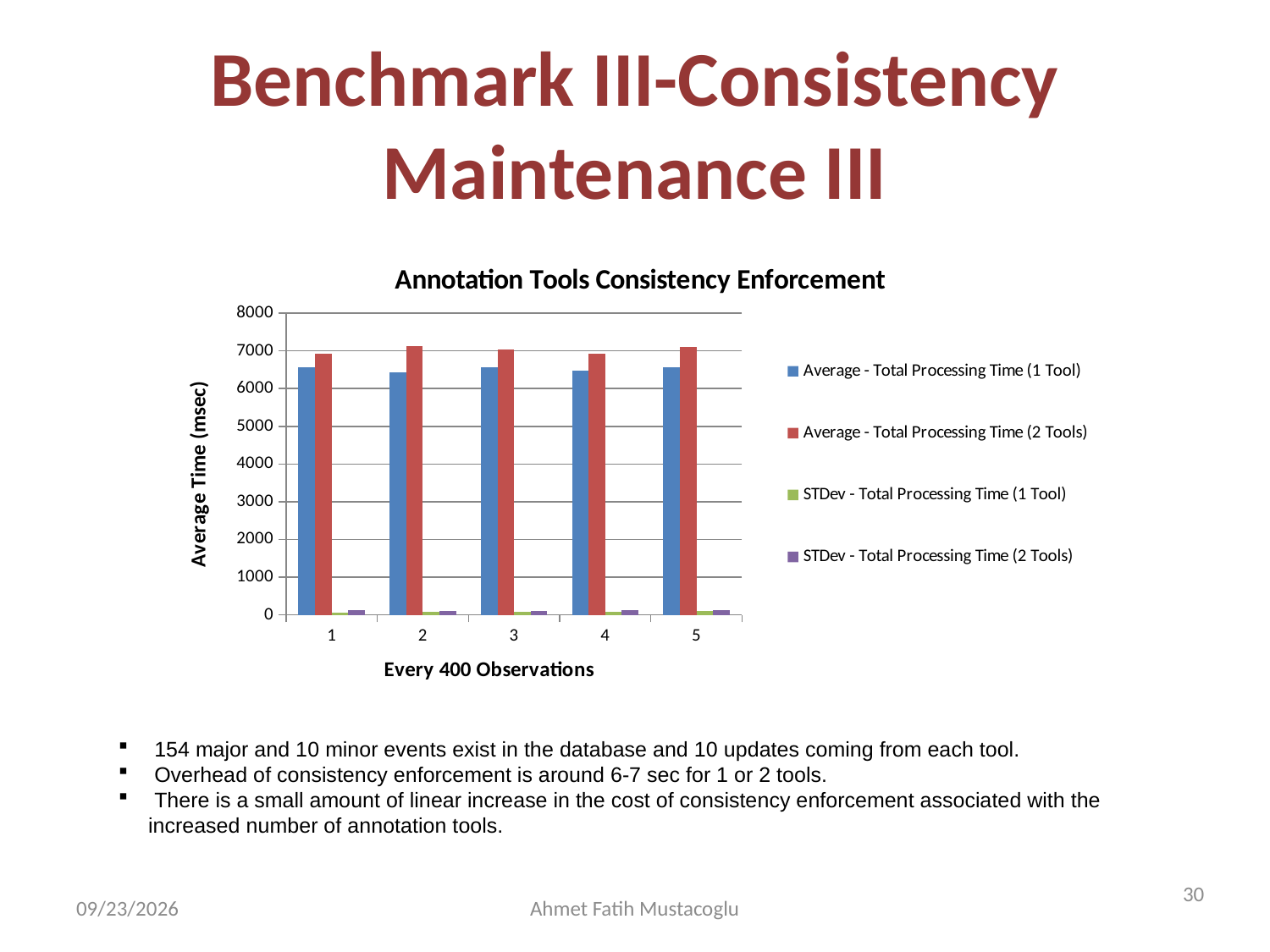
How many series does the legend list? 4 At observation group 4, which is larger: Average - Total Processing Time (1 Tool) or STDev - Total Processing Time (1 Tool)? Average - Total Processing Time (1 Tool) Is the value for Average - Total Processing Time (2 Tools) at observation group 5 greater or less than 5000? greater What is the title of the chart? Annotation Tools Consistency Enforcement At observation group 1, which is larger: Average - Total Processing Time (1 Tool) or Average - Total Processing Time (2 Tools)? Average - Total Processing Time (2 Tools) Is the value for Average - Total Processing Time (1 Tool) at observation group 2 greater or less than 7000? less What kind of chart is shown on the slide? bar chart Is the value for Average - Total Processing Time (1 Tool) at observation group 1 greater or less than 6000? greater What is the label of the vertical axis? Average Time (msec) How many observation groups are shown along the x axis? 5